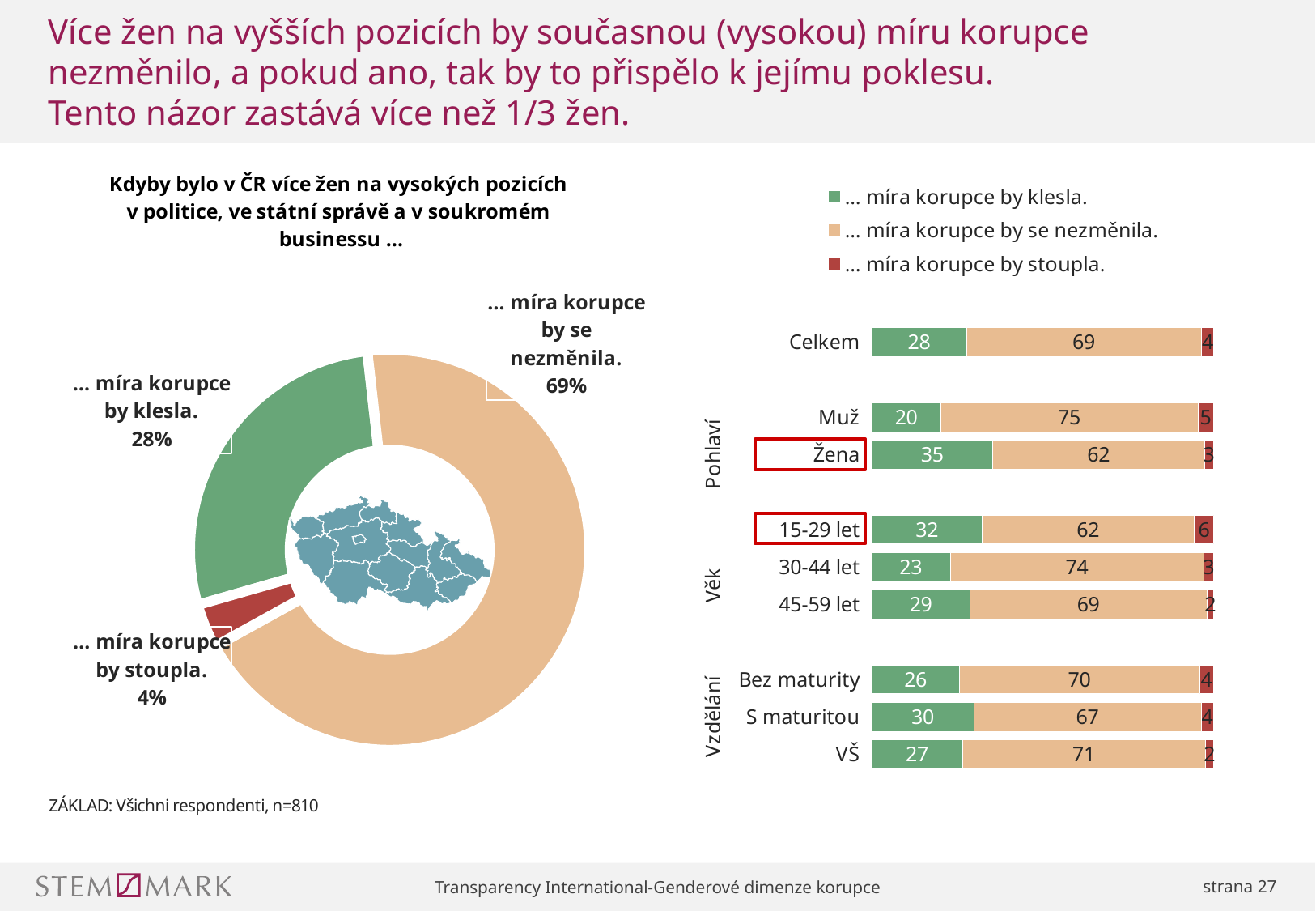
In the stacked bar chart on the right, what is the difference between the "… míra korupce by klesla." values for Žena and Muž? 15 In the stacked bar chart on the right, which is larger: the "… míra korupce by se nezměnila." value for 30-44 let or for 45-59 let? 30-44 let What kind of chart is shown on the left side of the slide? Donut (pie) chart In the stacked bar chart on the right, what is the value for "… míra korupce by se nezměnila." for Muž? 75 In the donut chart on the left, what share of respondents said the level of corruption would decrease ("… míra korupce by klesla.")? 28% In the donut chart on the left, which response has the largest share? … míra korupce by se nezměnila. In the stacked bar chart on the right, which category has the highest value for "… míra korupce by stoupla."? 15-29 let How many series does the legend of the stacked bar chart on the right list? 3 In the donut chart on the left, what share of respondents said the level of corruption would increase ("… míra korupce by stoupla.")? 4% In the stacked bar chart on the right, what is the value for "… míra korupce by klesla." for Žena? 35 How many categories (bars) are shown in the stacked bar chart on the right? 9 In the stacked bar chart on the right, which category has the lowest value for "… míra korupce by klesla."? Muž